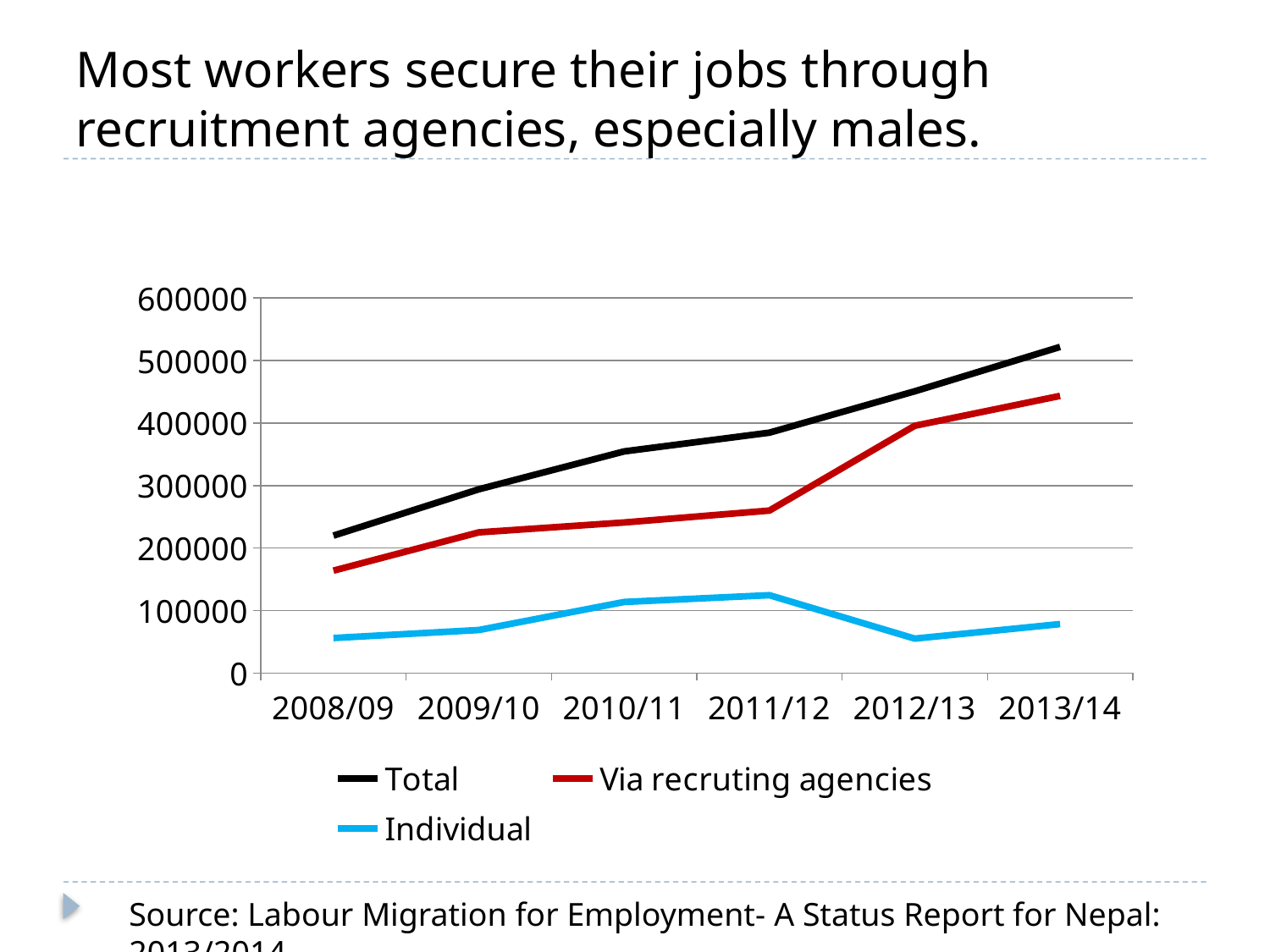
In which year is the Via recruting agencies series at its lowest? 2008/09 In which year is the Individual series at its highest? 2011/12 Which series is shown with the red line? Via recruting agencies Is the value for Total in 2013/14 greater or less than 500000? greater In which year is the Total series at its highest? 2013/14 Is the value for Individual in 2012/13 greater or less than 100000? less How many series does the legend list? 3 What kind of chart is shown on the slide? line chart Is the value for Via recruting agencies in 2011/12 greater or less than 300000? less How many years are plotted along the x axis? 6 Does the Total series rise or fall from 2008/09 to 2013/14? rise